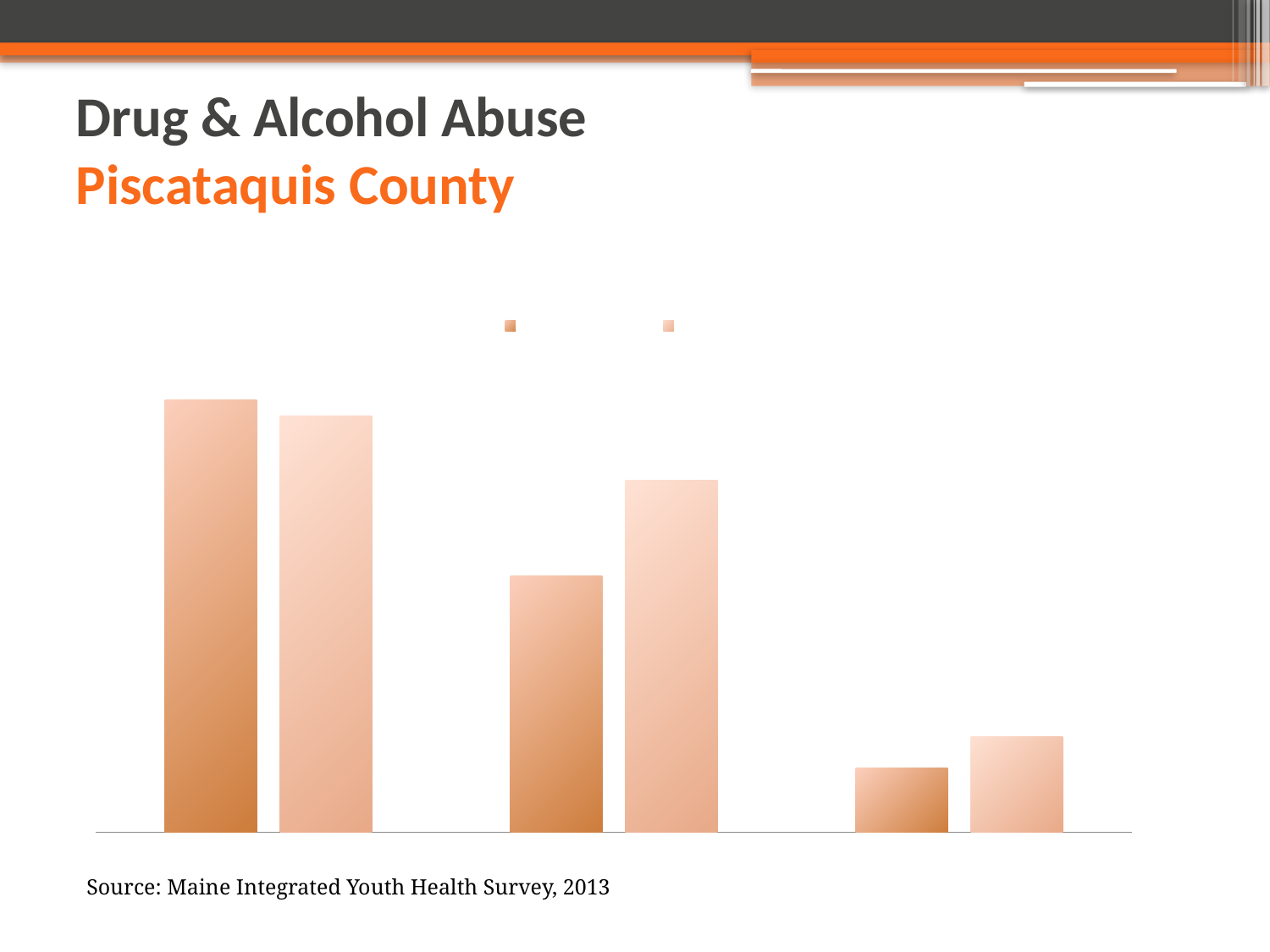
What kind of chart is shown on the slide? bar chart In the rightmost group of bars, is the darker orange bar or the lighter orange bar taller? the lighter orange bar In the middle group of bars, is the darker orange bar or the lighter orange bar taller? the lighter orange bar How many groups of bars are plotted in the chart? 3 How many bars are plotted in total in the chart? 6 What source is cited below the chart? Maine Integrated Youth Health Survey, 2013 Do the lighter orange bars rise or fall from left to right across the chart? fall Which group of bars contains the shortest bar in the chart? the rightmost group How many series does the chart's legend list? 2 Which group of bars contains the tallest bar in the chart? the leftmost group In the leftmost group of bars, is the darker orange bar or the lighter orange bar taller? the darker orange bar Do the darker orange bars rise or fall from left to right across the chart? fall